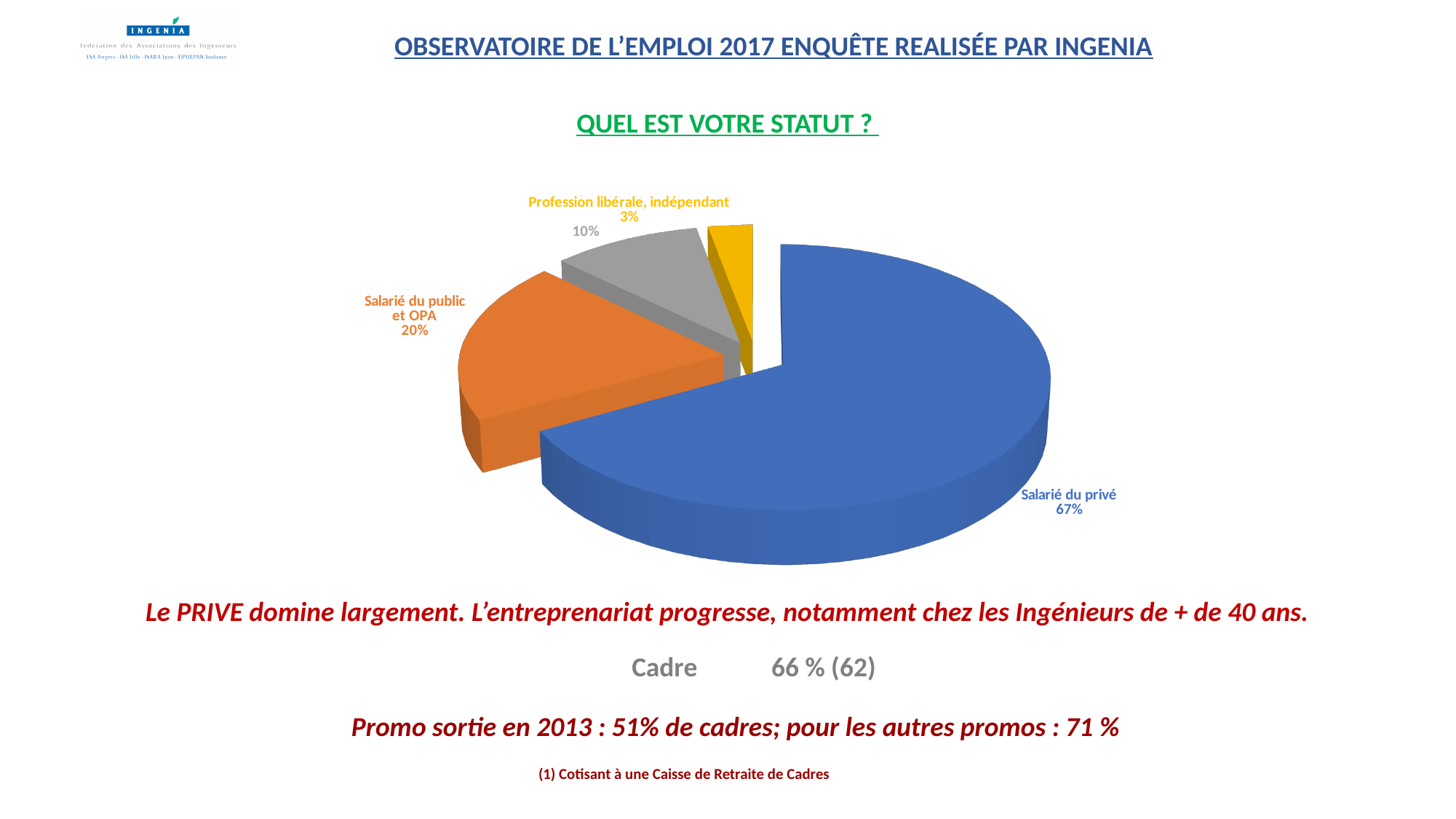
How many slices does the pie chart have? 4 What colour is the "Salarié du privé" slice? blue Which category has the smallest slice of the pie? Profession libérale, indépendant What kind of chart is shown on the slide? pie chart What is the title of the pie chart? QUEL EST VOTRE STATUT ? What share of the pie does "Salarié du privé" represent? 67% Which category has the largest slice of the pie? Salarié du privé What is the difference in percentage points between "Salarié du privé" and "Salarié du public et OPA"? 47 What is the difference in percentage points between "Salarié du public et OPA" and "Profession libérale, indépendant"? 17 Which is larger: the share for "Salarié du public et OPA" or the share for "Profession libérale, indépendant"? Salarié du public et OPA What share of the pie does "Salarié du public et OPA" represent? 20% What share of the pie does "Profession libérale, indépendant" represent? 3%